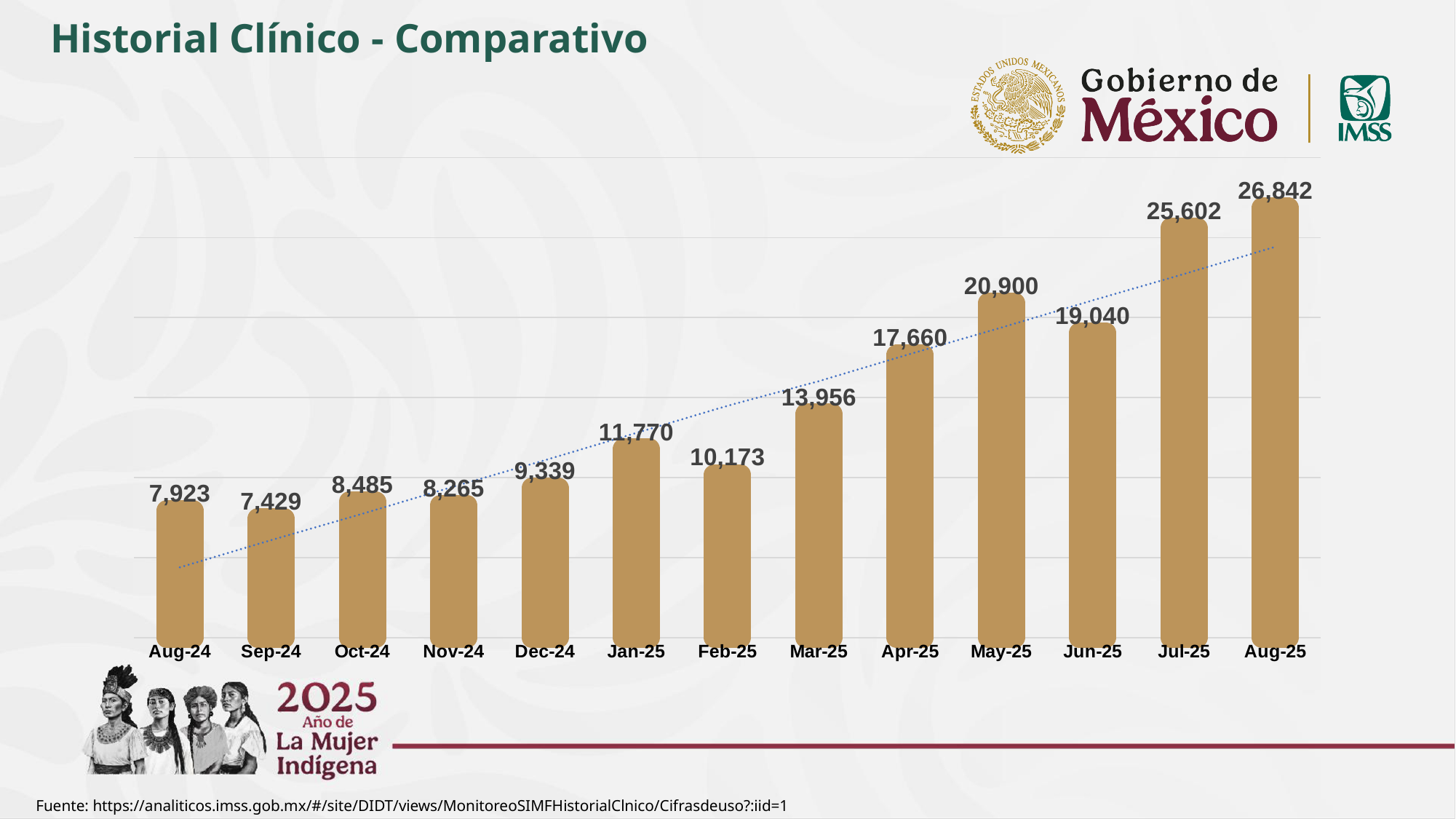
How many months are shown on the x axis? 13 What kind of chart is shown on the slide? Bar chart What is the value for Feb-25? 10,173 What is the difference between the values for May-25 and Jun-25? 1,860 Which is larger, the value for Jan-25 or the value for Feb-25? Jan-25 What is the difference between the values for Aug-25 and Jul-25? 1,240 What is the title of the slide containing the chart? Historial Clínico - Comparativo What is the value for Aug-25? 26,842 Do the values generally rise or fall from Aug-24 to Aug-25? Rise Which month has the highest value? Aug-25 What is the value for Nov-24? 8,265 Which month has the lowest value? Sep-24